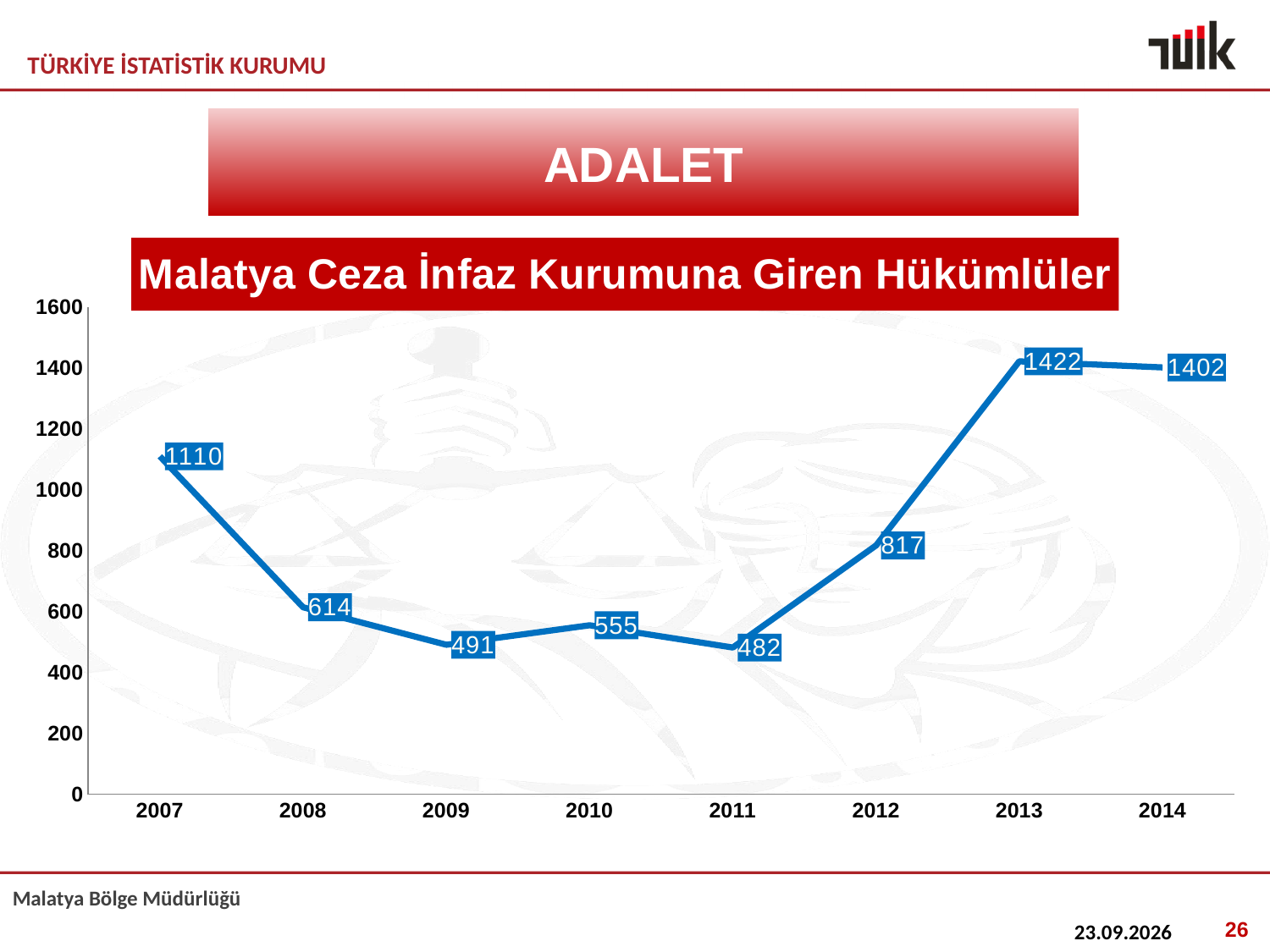
Which is larger, the value for 2008 or the value for 2010? 2008 Which year has the highest value? 2013 Which year has the lowest value? 2011 What is the value for 2011? 482 Is the value for 2012 greater or less than 800? greater What kind of chart is this? line chart What is the value for 2007? 1110 Do the values rise or fall from 2011 to 2013? rise What is the title of the chart? Malatya Ceza İnfaz Kurumuna Giren Hükümlüler How many years are shown on the x axis? 8 What is the value for 2014? 1402 What is the difference between the values for 2013 and 2012? 605